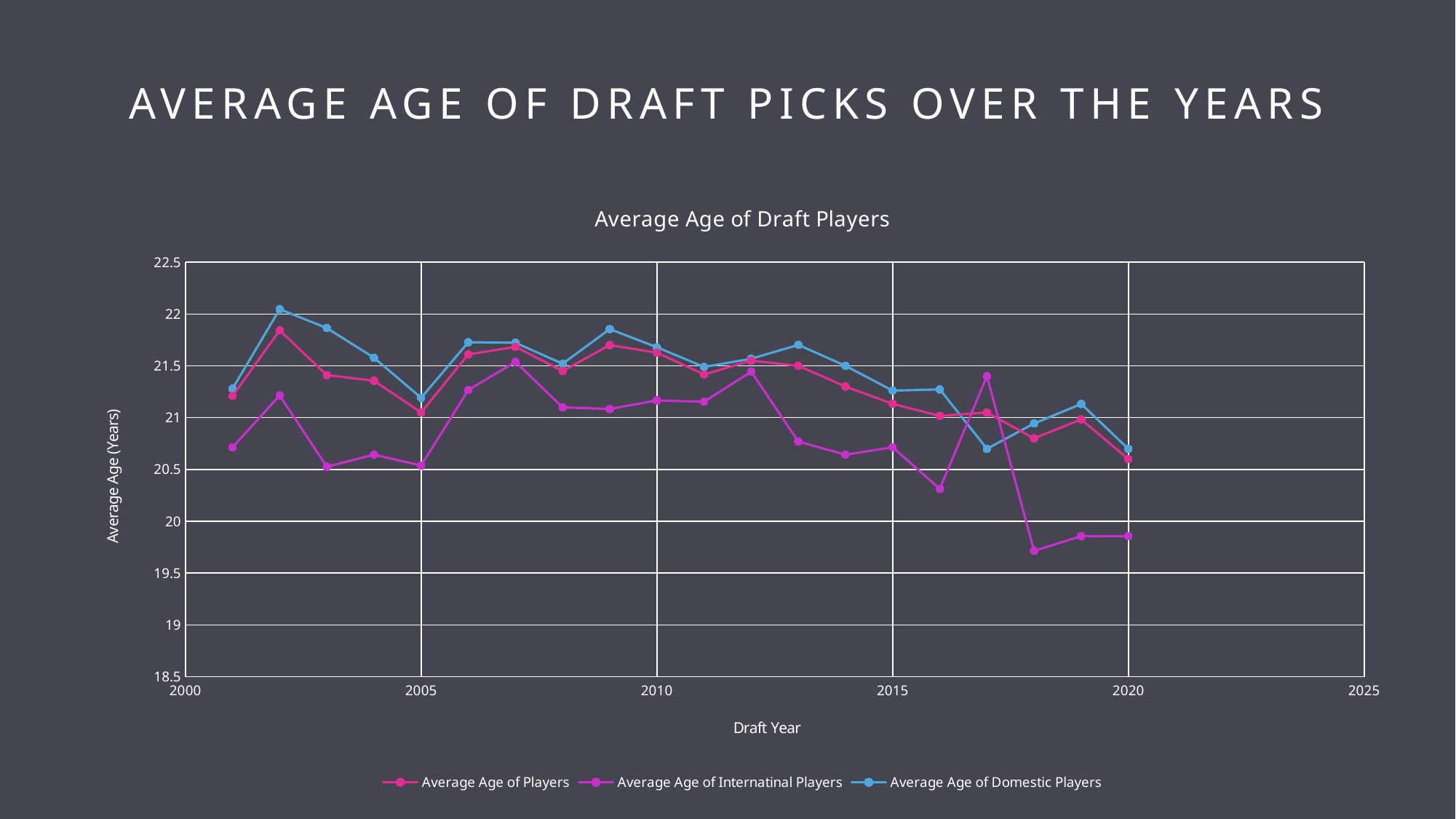
How many data points does each series have? 20 Is the value for Average Age of Internatinal Players in 2018 greater or less than 20? less In which year does the Average Age of Domestic Players series reach its highest value? 2002 How many series does the legend list? 3 Is the value for Average Age of Internatinal Players in 2003 greater or less than 21? less In which year does the Average Age of Internatinal Players series reach its lowest value? 2018 In 2017, which is larger: Average Age of Internatinal Players or Average Age of Domestic Players? Average Age of Internatinal Players Is the value for Average Age of Players in 2020 greater or less than 21? less What kind of chart is shown on the slide? line chart What is the title of the chart? Average Age of Draft Players Does the Average Age of Internatinal Players series rise or fall from 2017 to 2018? fall